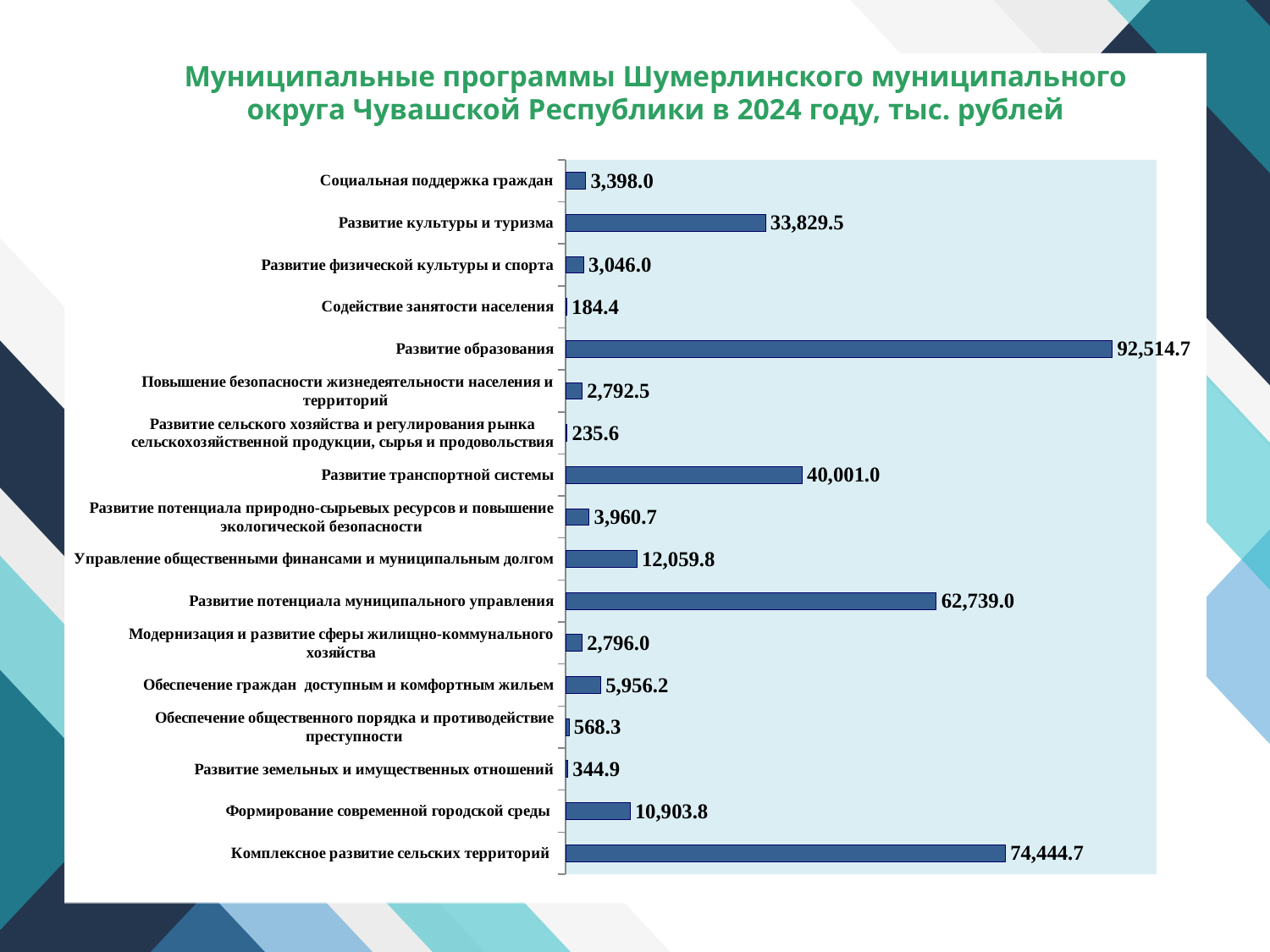
What is the difference between Развитие транспортной системы and Развитие культуры и туризма? 6,171.5 What is the value for Содействие занятости населения? 184.4 What is the value for Развитие образования? 92,514.7 What is the value for Развитие транспортной системы? 40,001.0 What type of chart is shown on the slide? Bar chart Which is larger: Развитие потенциала муниципального управления or Комплексное развитие сельских территорий? Комплексное развитие сельских территорий What is the difference between Развитие образования and Комплексное развитие сельских территорий? 18,070.0 Which program has the lowest value? Содействие занятости населения What is the value for Формирование современной городской среды? 10,903.8 What unit of measurement is stated in the chart title? тыс. рублей How many programs (categories) are shown in the chart? 17 Which program has the highest value? Развитие образования